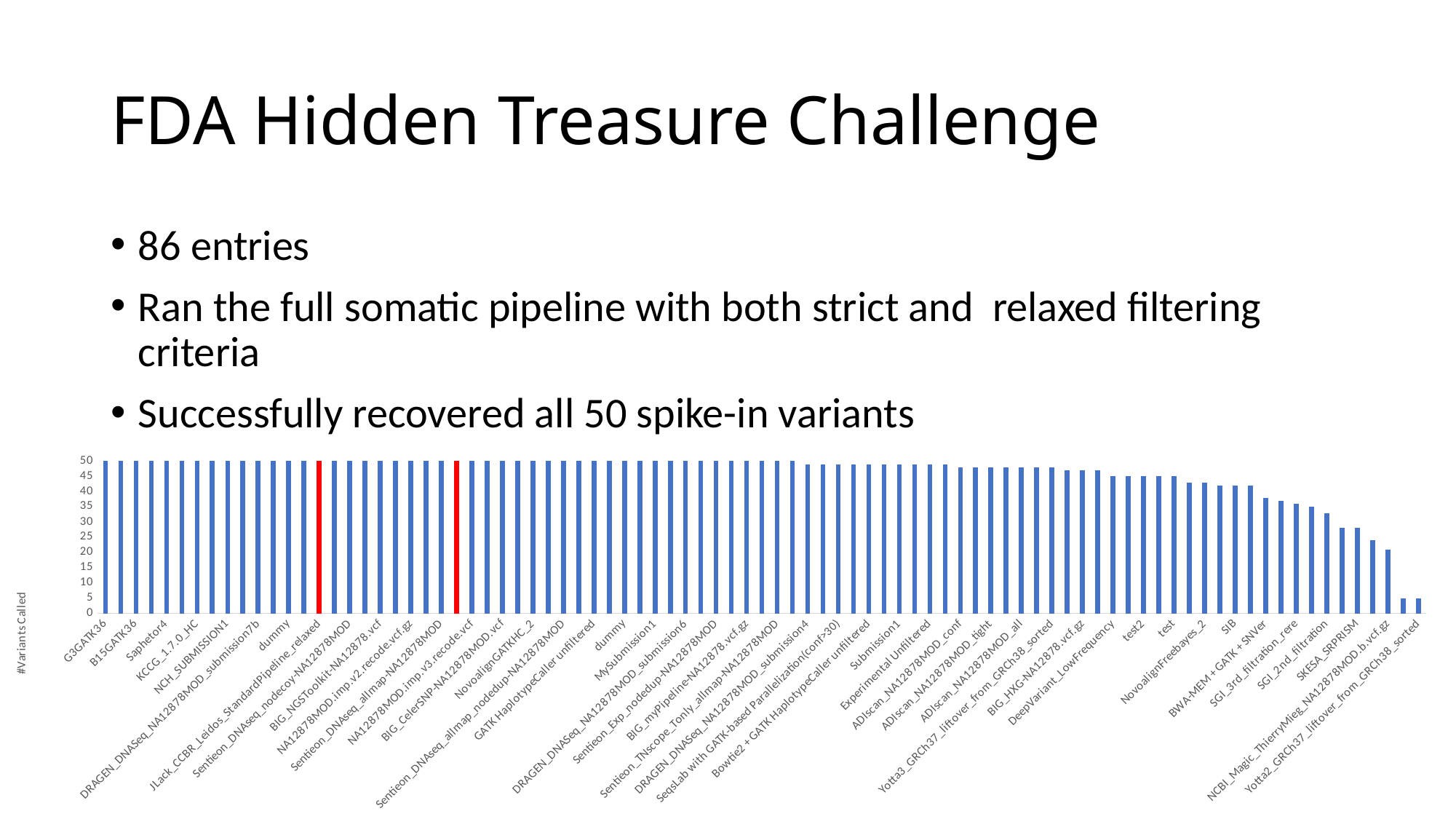
What kind of chart is shown on the slide? bar chart What is the highest value reached by any bar in the chart? 50 Do the bar values rise or fall moving from left to right along the x axis? fall What is the label on the vertical axis of the chart? #Variants Called How many bars in the chart are coloured red instead of blue? 2 Is the value for SKESA_SRPRISM greater or less than 40? less Which has the larger value, G3GATK36 or NCBI_Magic_ThierryMieg_NA12878MOD.b.vcf.gz? G3GATK36 Is the value for Yotta2_GRCh37_liftover_from_GRCh38_sorted greater or less than 30? less Is the value for test greater or less than 40? greater What is the value for G3GATK36? 50